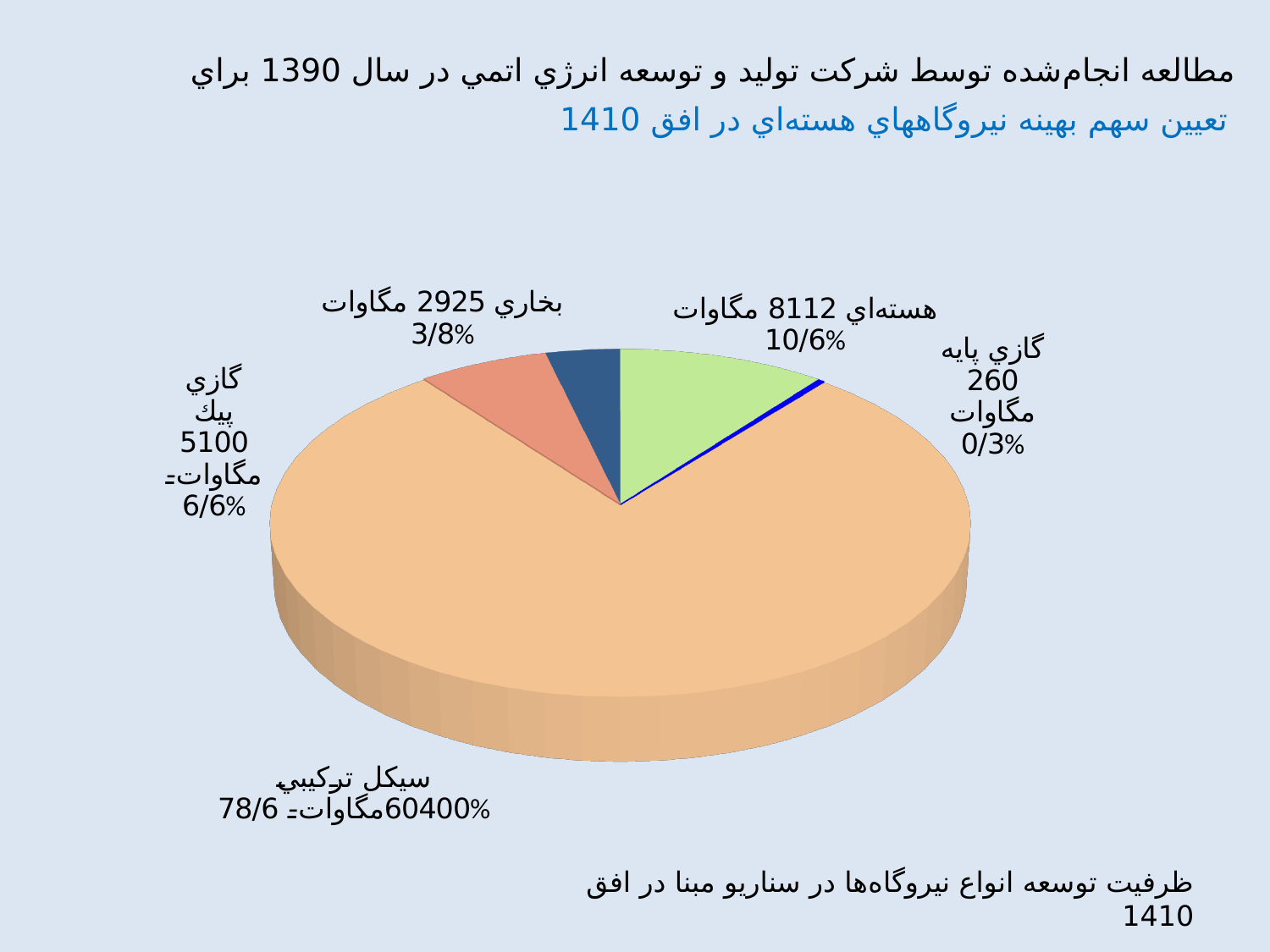
Which is larger, the capacity for گازي پيك or for بخاري? گازي پيك What colour is the slice for هسته‌اي? light green What capacity in megawatts is shown for گازي پيك? 5100 مگاوات What capacity in megawatts is shown for هسته‌اي (nuclear)? 8112 مگاوات Which category has the smallest slice of the pie? گازي پايه Which category has the largest slice of the pie? سيكل تركيبي What kind of chart is shown on the slide? pie chart How many slices does the pie chart have? 5 What percentage share is shown for گازي پايه? 0/3% What percentage share is shown for بخاري? 3/8% What capacity in megawatts is shown for سيكل تركيبي (combined cycle)? 60400 مگاوات What is the difference in megawatts between هسته‌اي and بخاري? 5187